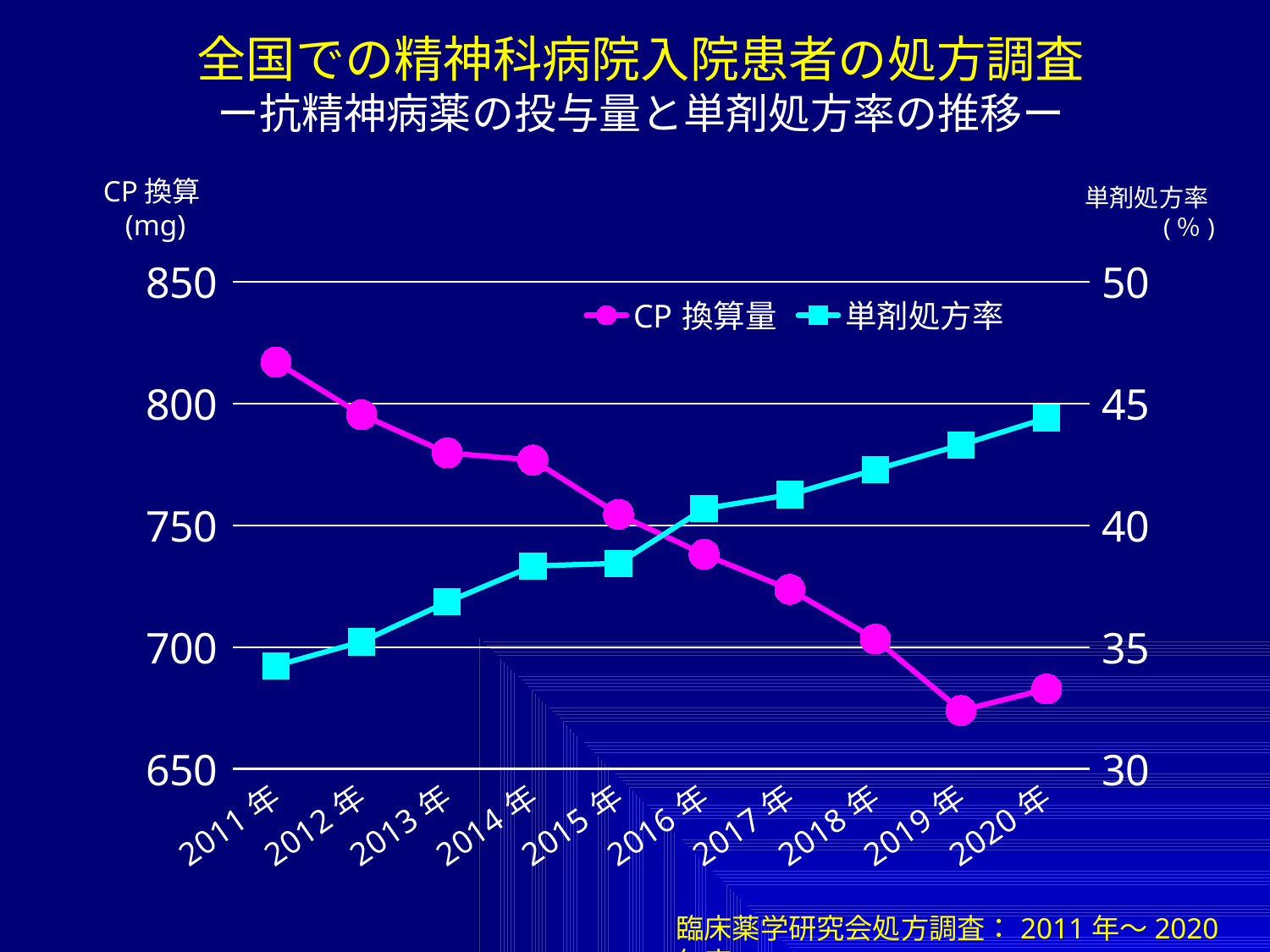
What kind of chart is shown on the slide? line chart Is the 単剤処方率 value for 2016年 greater or less than 40? greater Is the CP換算量 value for 2019年 greater or less than 700? less Does the 単剤処方率 series rise or fall from 2011年 to 2020年? rise In which year is the 単剤処方率 value lowest? 2011年 How many years are plotted along the x axis? 10 Is the CP換算量 value for 2011年 greater or less than 800? greater In which year is the CP換算量 value lowest? 2019年 In which year is the CP換算量 value highest? 2011年 Does the CP換算量 series rise or fall from 2011年 to 2020年? fall How many series does the legend list? 2 In which year is the 単剤処方率 value highest? 2020年